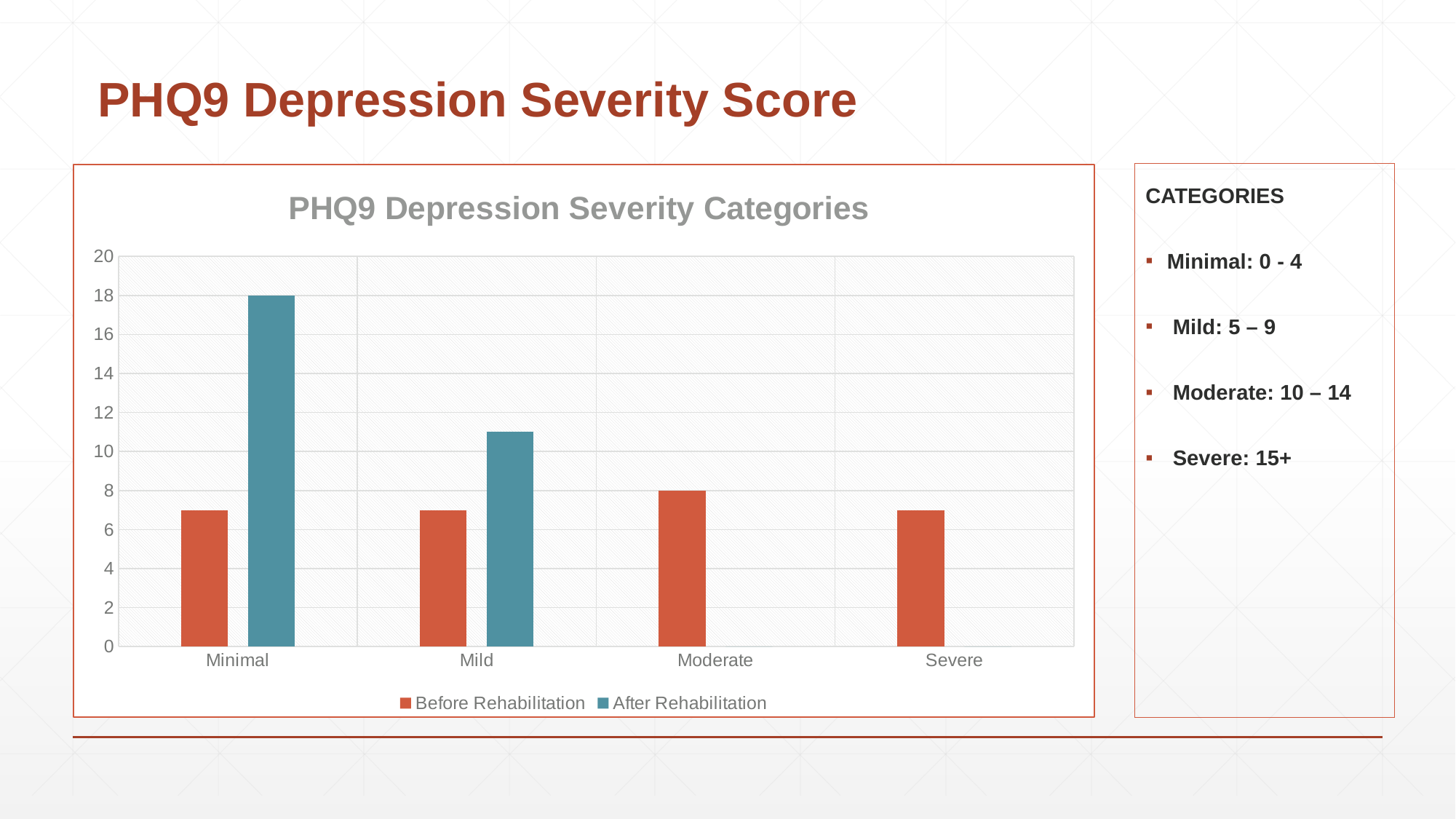
Is the Before Rehabilitation value for Minimal greater or less than 6? greater What is the title of the chart? PHQ9 Depression Severity Categories Is the After Rehabilitation value for Mild greater or less than 10? greater What is the difference between the After Rehabilitation value for Minimal and the Before Rehabilitation value for Moderate? 10 Which category has the highest After Rehabilitation value? Minimal How many series does the chart legend list? 2 Is the Before Rehabilitation value for Severe greater or less than 8? less What is the After Rehabilitation value for the Minimal category? 18 What is the Before Rehabilitation value for the Moderate category? 8 Which is larger: the After Rehabilitation value for Minimal or the After Rehabilitation value for Mild? After Rehabilitation value for Minimal How many categories are shown on the x axis of the chart? 4 What kind of chart is shown on the slide? Bar chart